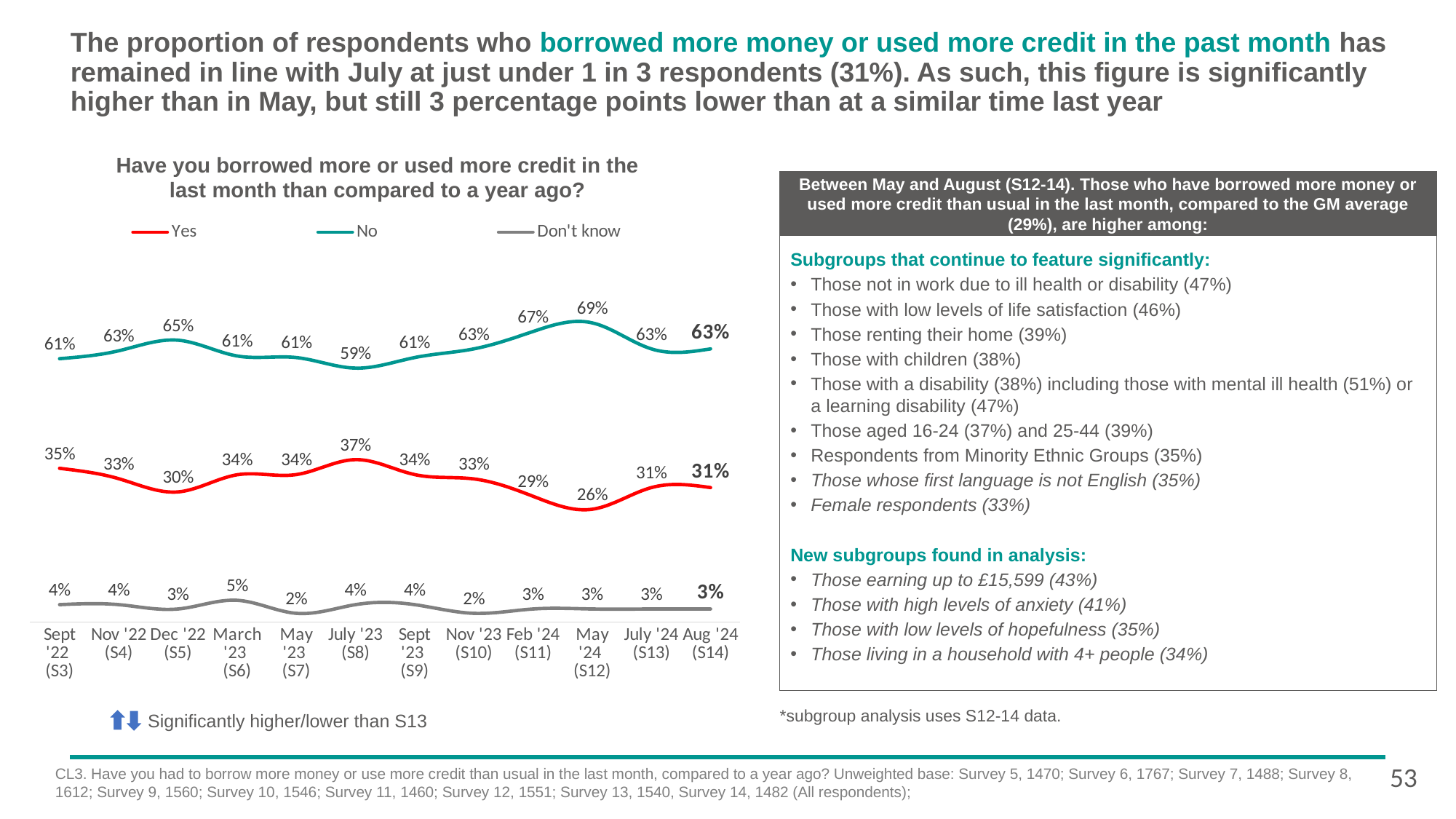
How many series does the legend list? 3 What type of chart is shown on the slide? Line chart Which is larger: the 'Yes' value in Sept '22 (S3) or the 'Yes' value in Feb '24 (S11)? Sept '22 (S3) What is the value for 'Don't know' in March '23 (S6)? 5% In which survey wave is the 'Yes' series at its highest? July '23 (S8) What is the value for 'No' in May '24 (S12)? 69% What is the difference between the 'Yes' value in July '23 (S8) and the 'Yes' value in May '24 (S12)? 11 percentage points In which survey wave is the 'Yes' series at its lowest? May '24 (S12) What is the difference between the 'No' value in May '24 (S12) and the 'No' value in Aug '24 (S14)? 6 percentage points What is the value for 'Yes' in Aug '24 (S14)? 31% Which series is shown in red in the legend? Yes How many survey waves (time points) are plotted along the x axis? 12